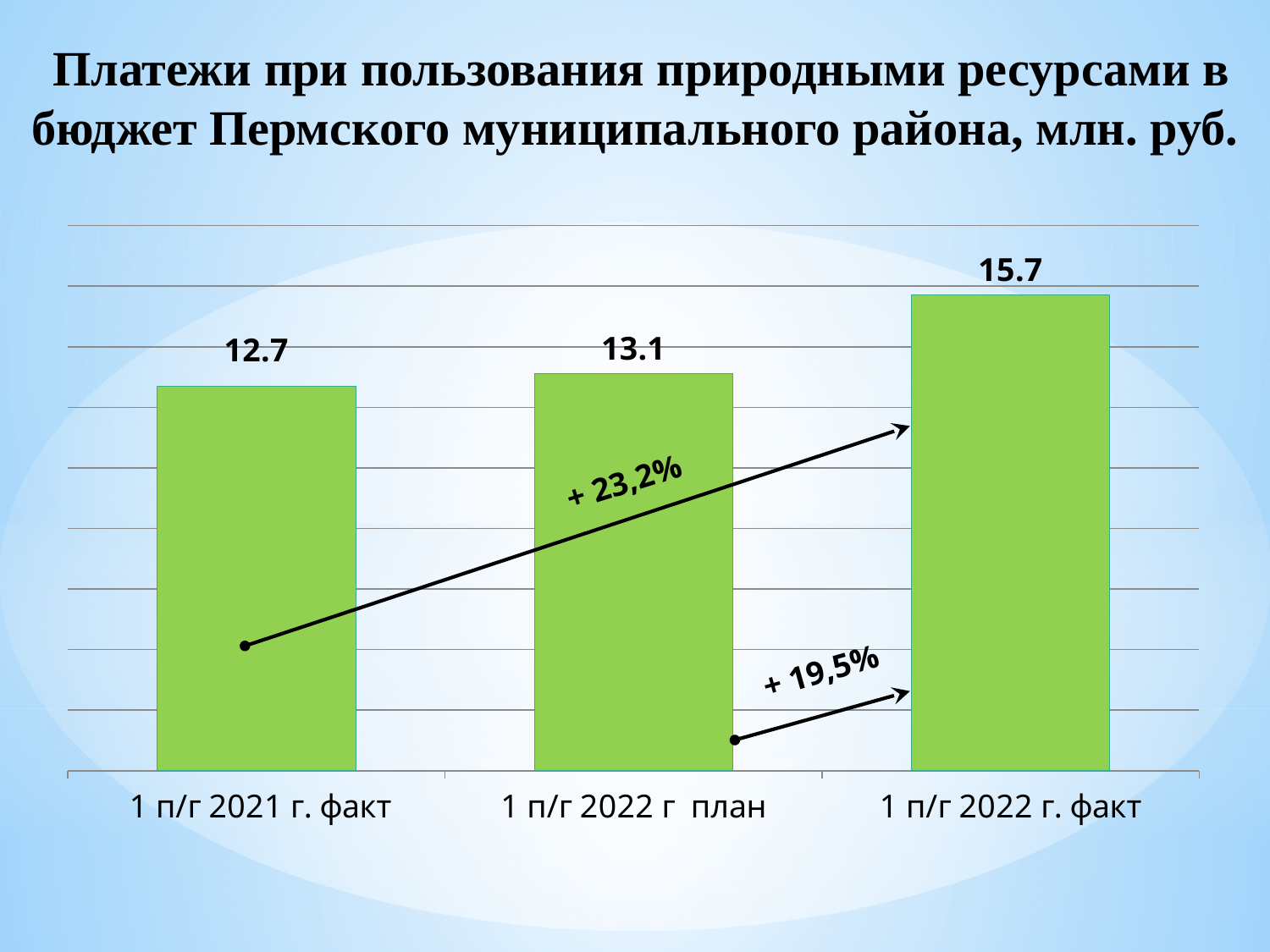
What percentage change is annotated on the arrow from "1 п/г 2022 г план" to "1 п/г 2022 г. факт"? + 19,5% What is the value for "1 п/г 2022 г план"? 13.1 Which category has the lowest value? 1 п/г 2021 г. факт What kind of chart is shown on the slide? Bar chart Which category has the highest value? 1 п/г 2022 г. факт What is the difference between the values for "1 п/г 2022 г. факт" and "1 п/г 2021 г. факт"? 3.0 How many categories are shown in the chart? 3 What is the difference between the values for "1 п/г 2022 г. факт" and "1 п/г 2022 г план"? 2.6 Which is larger, the value for "1 п/г 2022 г план" or the value for "1 п/г 2021 г. факт"? 1 п/г 2022 г план Do the values rise or fall from left to right along the x axis? Rise What is the value for "1 п/г 2021 г. факт"? 12.7 What is the value for "1 п/г 2022 г. факт"? 15.7